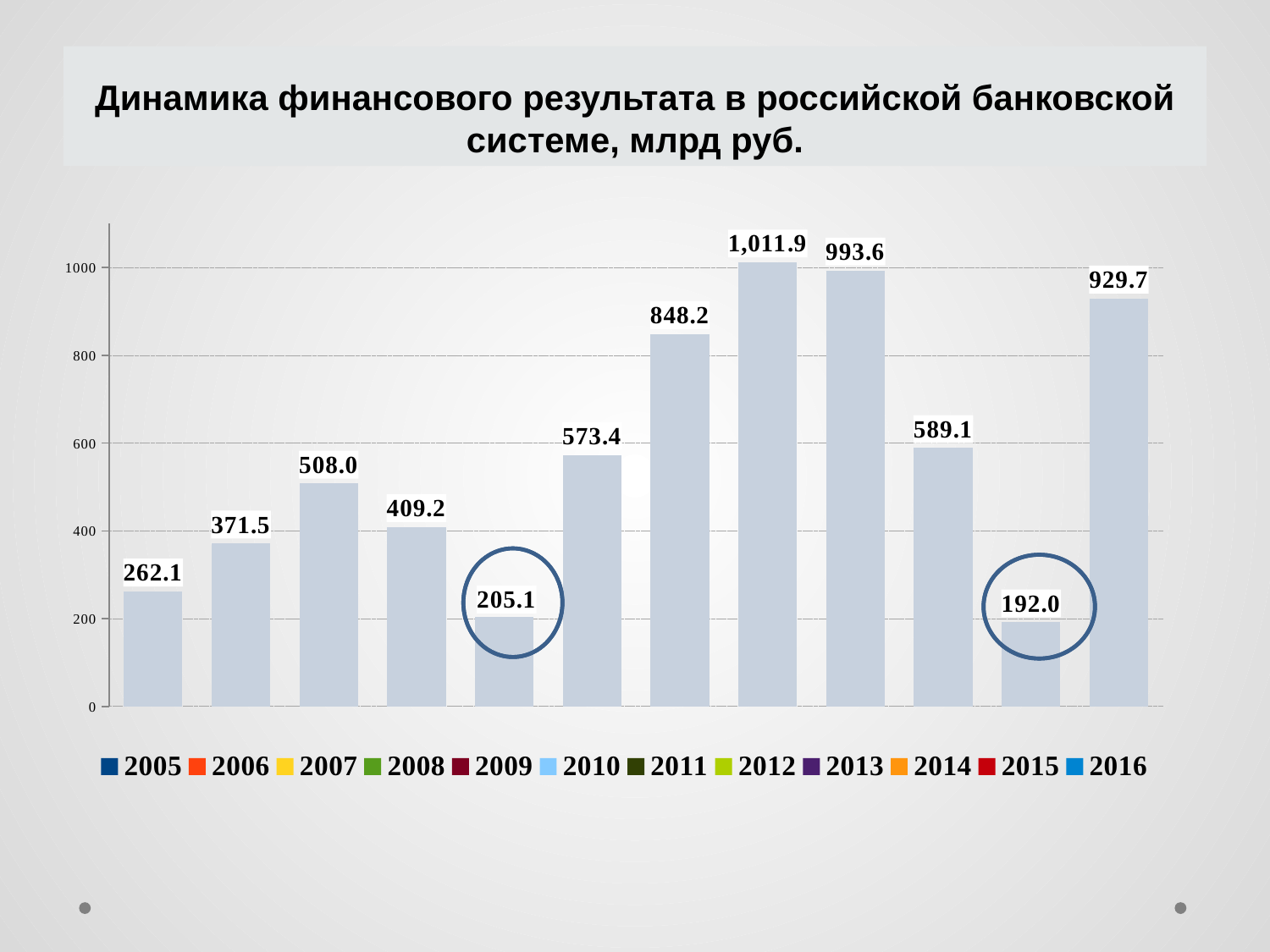
What is the value of the lowest bar in the chart? 192.0 How many entries does the legend list? 12 What is the value of the highest bar in the chart? 1,011.9 What is the title of the chart? Динамика финансового результата в российской банковской системе, млрд руб. What is the value shown for 2016 (the rightmost bar)? 929.7 Which is larger, the value for 2007 (508.0) or the value for 2008 (409.2)? 2007 (508.0) Do the values rise or fall from 2013 to 2015? fall What is the value shown for 2005 (the leftmost bar)? 262.1 What type of chart is shown on the slide? bar chart What is the difference between the values for 2012 (1,011.9) and 2013 (993.6)? 18.3 What is the value shown for 2009 (the fifth bar from the left)? 205.1 How many bars are plotted in the chart? 12